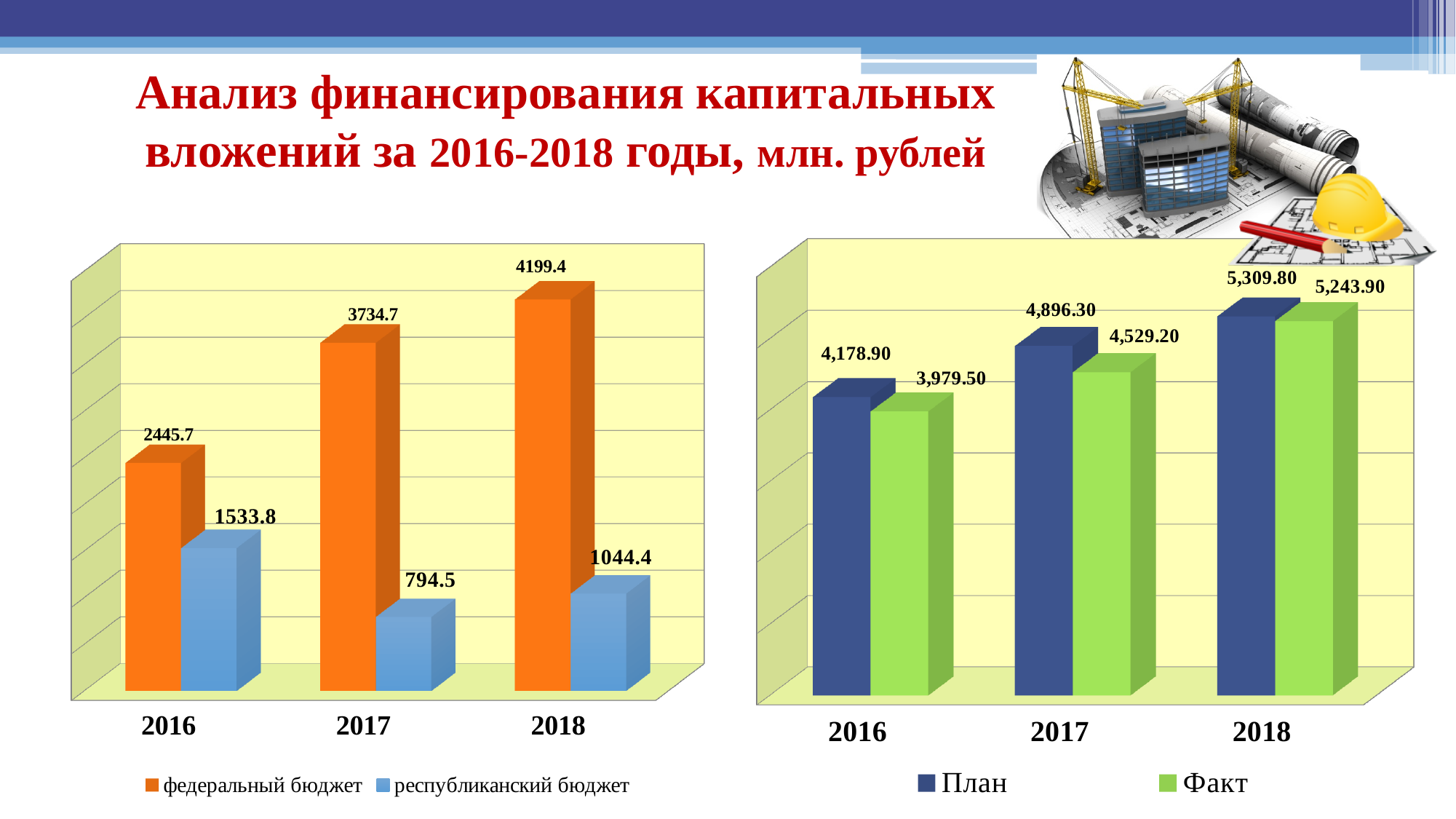
In the left chart, what is the value for республиканский бюджет in 2017? 794.5 In the right chart, do the Факт values rise or fall from 2016 to 2018? rise In the right chart, which is larger in 2017, План or Факт? План In the right chart, what is the difference between План and Факт in 2018? 65.90 In the left chart, what is the value for федеральный бюджет in 2018? 4199.4 In the right chart, what is the Факт value for 2016? 3,979.50 In the left chart, what is the difference between федеральный бюджет and республиканский бюджет in 2016? 911.9 How many series does the legend of the right chart list? 2 In the right chart, what is the План value for 2017? 4,896.30 In the left chart, which year has the highest value for республиканский бюджет? 2016 What type of chart is the left chart? bar chart In the left chart, which year has the lowest value for федеральный бюджет? 2016